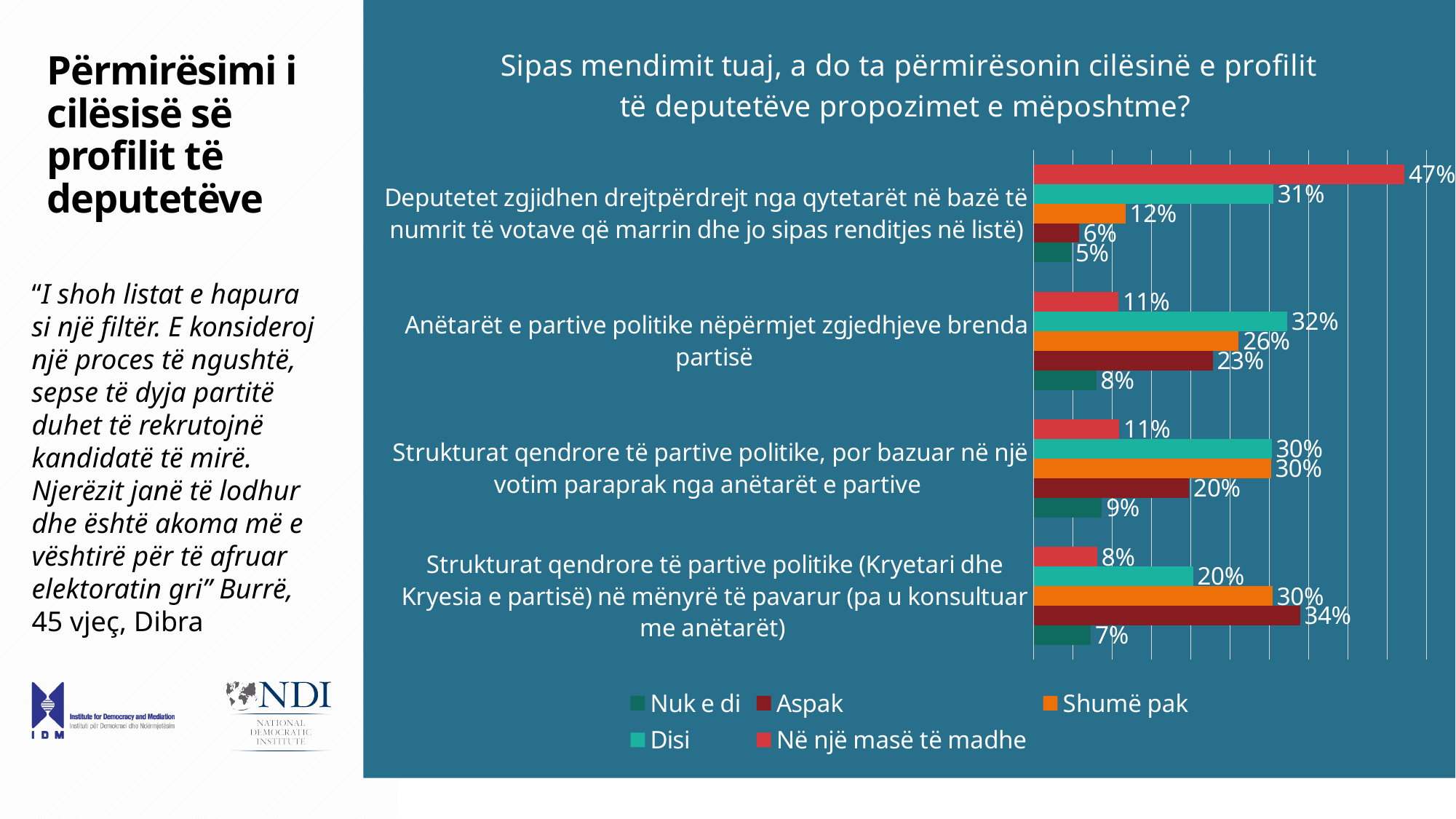
Which legend entry is shown in orange? Shumë pak Which proposal has the lowest "Nuk e di" value? Deputetet zgjidhen drejtpërdrejt nga qytetarët në bazë të numrit të votave që marrin dhe jo sipas renditjes në listë What percentage answered "Në një masë të madhe" for the proposal that deputies are elected directly by citizens based on the number of votes? 47% What kind of chart is shown on the slide? bar chart What is the difference between the "Në një masë të madhe" value for direct election by citizens (47%) and for party members through intra-party elections (11%)? 36 percentage points For the proposal that central party structures decide independently, which is larger: the "Aspak" value or the "Disi" value? Aspak How many proposals (categories) are shown in the chart? 4 What is the "Aspak" value for the proposal that central party structures decide independently (without consulting members)? 34% Which proposal has the highest "Në një masë të madhe" value? Deputetet zgjidhen drejtpërdrejt nga qytetarët në bazë të numrit të votave që marrin dhe jo sipas renditjes në listë What is the "Shumë pak" value for "Strukturat qendrore të partive politike, por bazuar në një votim paraprak nga anëtarët e partive"? 30% What is the "Disi" value for "Anëtarët e partive politike nëpërmjet zgjedhjeve brenda partisë"? 32% How many series does the legend list? 5